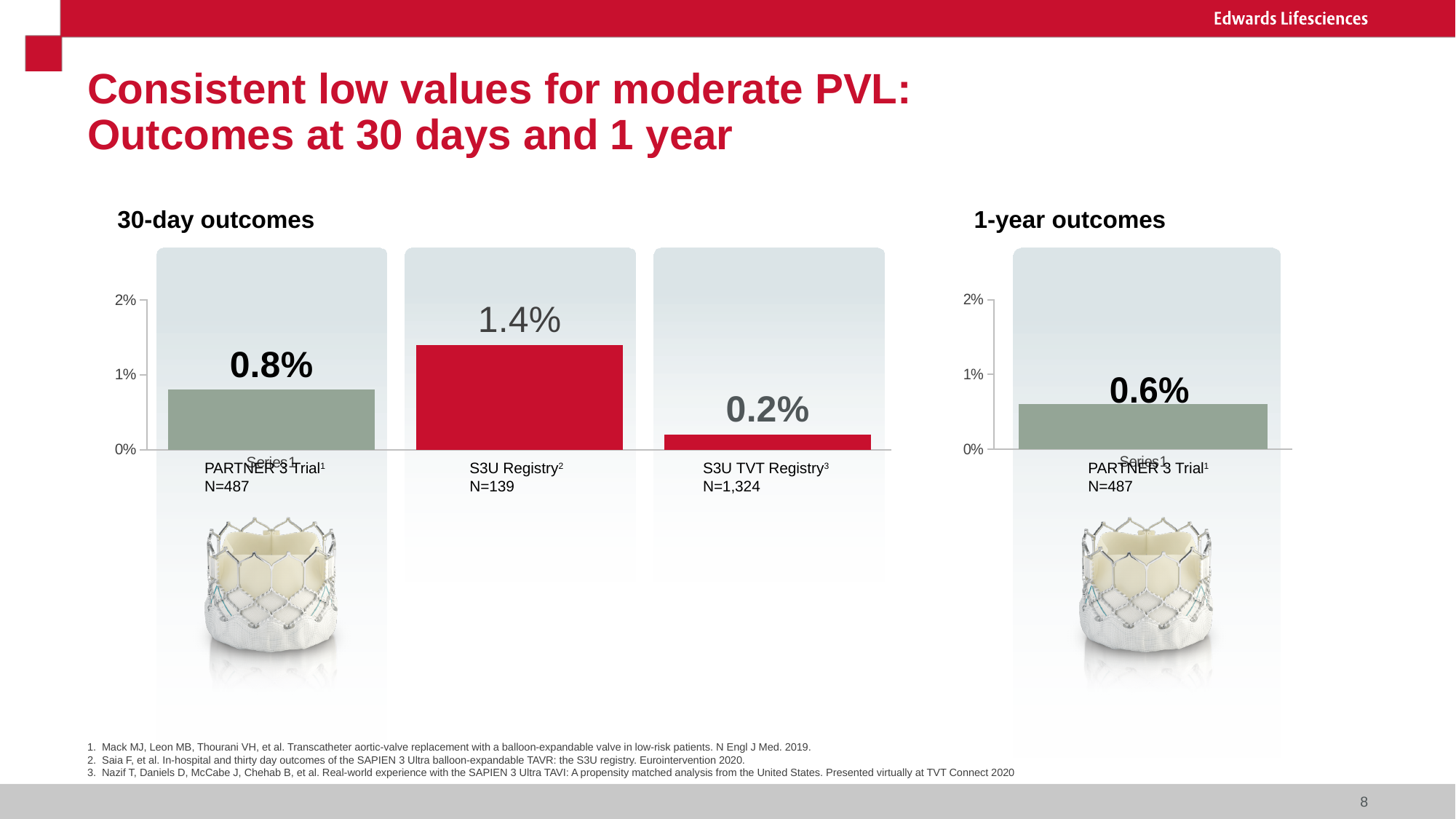
In the 30-day outcomes chart, what is the value for the S3U TVT Registry? 0.2% In the 30-day outcomes chart, what is the value for the PARTNER 3 Trial? 0.8% In the 30-day outcomes chart, what is the value for the S3U Registry? 1.4% How many bars are shown in the 30-day outcomes chart? 3 In the 30-day outcomes chart, which category has the lowest value? S3U TVT Registry In the 30-day outcomes chart, which category has the highest value? S3U Registry In the 30-day outcomes chart, is the value for the S3U Registry greater or less than 1%? greater In the 30-day outcomes chart, what is the difference between the S3U Registry value and the PARTNER 3 Trial value? 0.6% In the 30-day outcomes chart, what is the sample size (N) shown for the S3U TVT Registry? N=1,324 What kind of chart is the 1-year outcomes chart? bar chart In the 30-day outcomes chart, which is larger: the value for the PARTNER 3 Trial or the value for the S3U TVT Registry? PARTNER 3 Trial In the 1-year outcomes chart, what is the value for the PARTNER 3 Trial? 0.6%